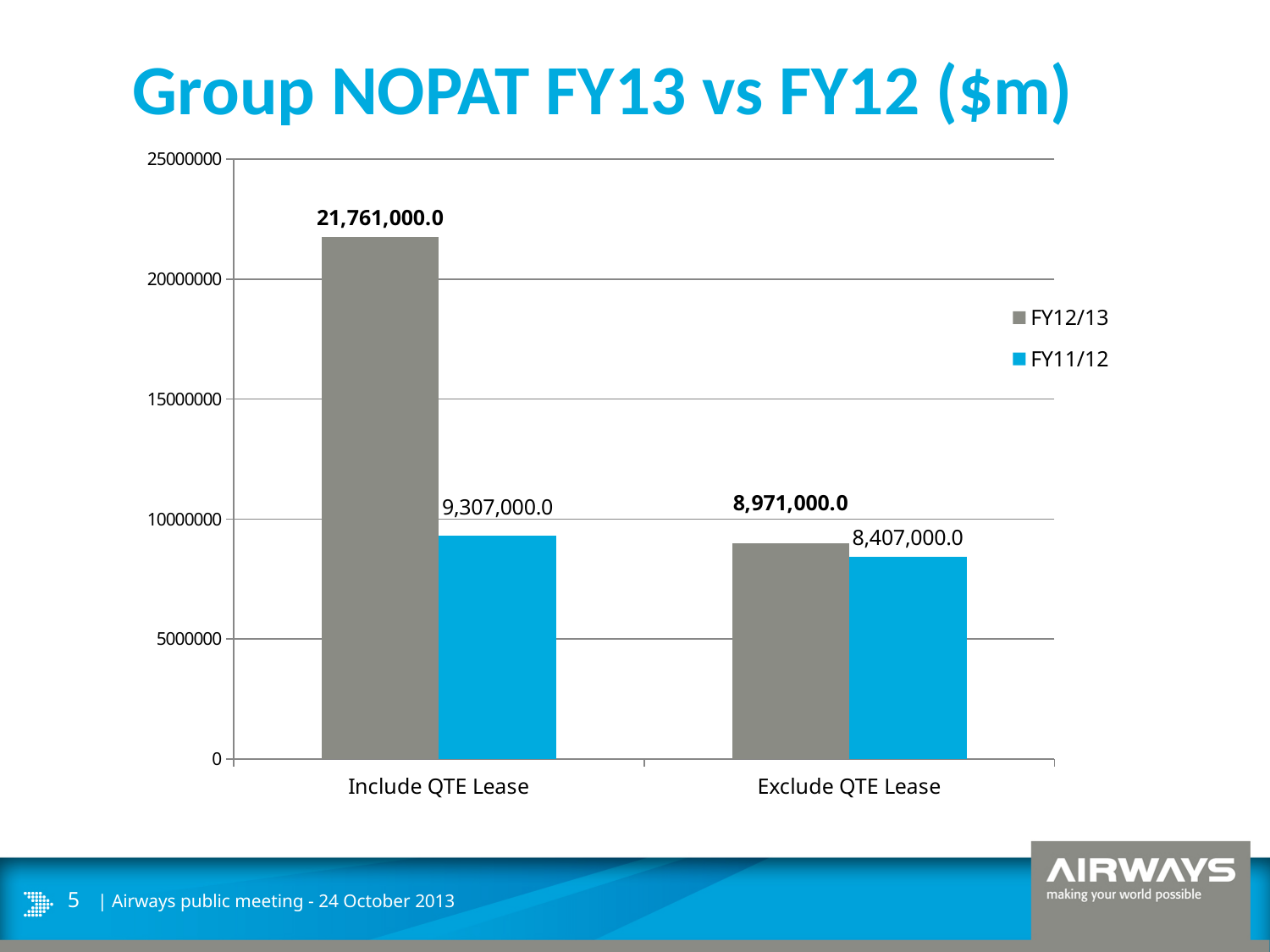
What is the FY11/12 value for Include QTE Lease? 9,307,000.0 Is the FY12/13 value for Include QTE Lease greater or less than 20000000? greater How many series does the legend list? 2 For Exclude QTE Lease, which is larger: the FY12/13 value or the FY11/12 value? FY12/13 What type of chart is shown on the slide? Bar chart Which bar has the lowest value on the chart? FY11/12 for Exclude QTE Lease What is the FY12/13 value for Exclude QTE Lease? 8,971,000.0 What is the difference between the FY12/13 and FY11/12 values for Include QTE Lease? 12,454,000.0 What is the FY11/12 value for Exclude QTE Lease? 8,407,000.0 What is the FY12/13 value for Include QTE Lease? 21,761,000.0 Which bar has the highest value on the chart? FY12/13 for Include QTE Lease What is the difference between the FY12/13 and FY11/12 values for Exclude QTE Lease? 564,000.0